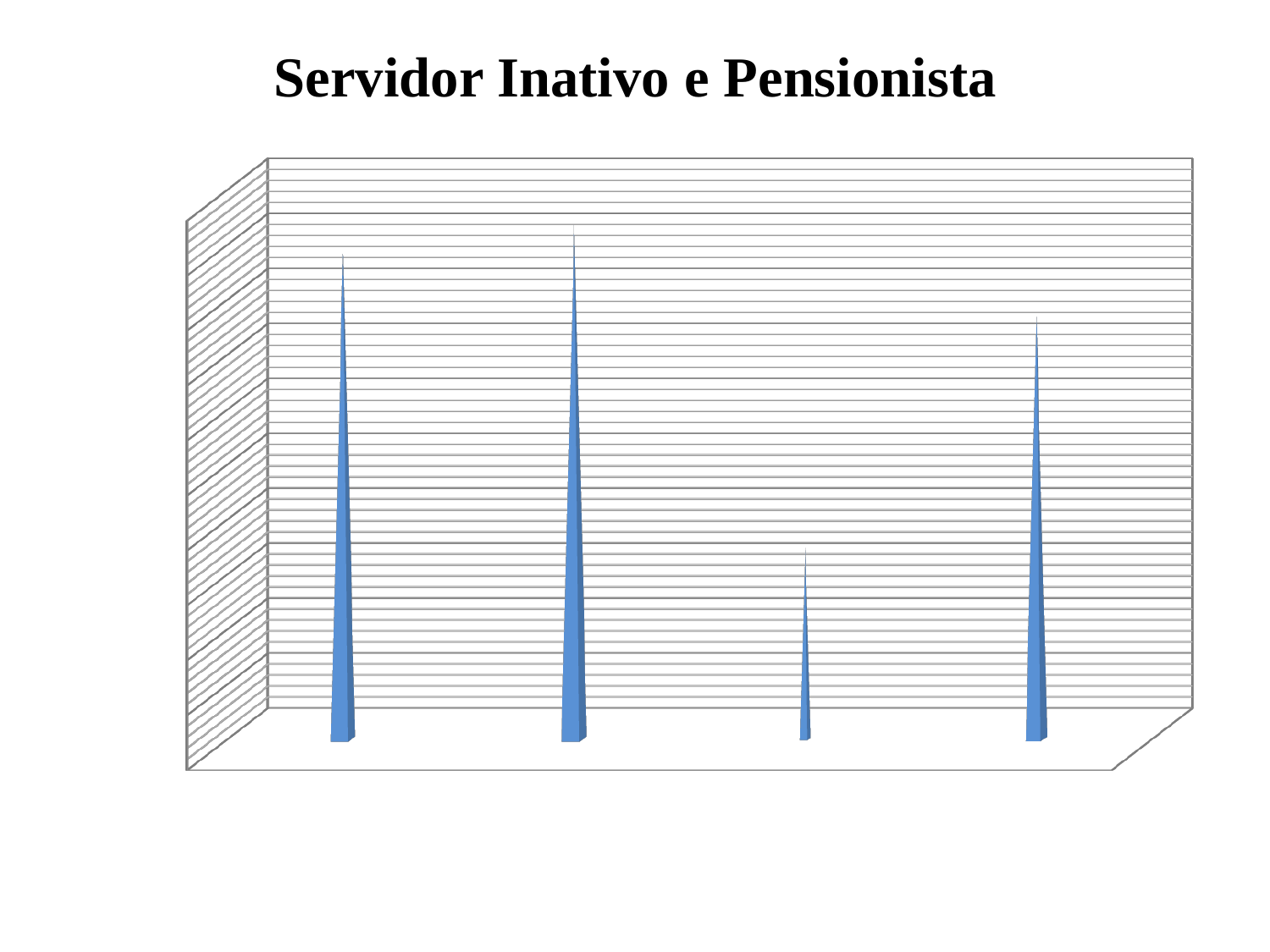
How many bars are plotted in the chart? 4 Which is taller, the second bar from the left or the third bar? the second bar Which bar is the tallest in the chart, counting from the left? the second bar What kind of chart is shown on the slide? bar chart What colour are the bars in the chart? blue Which bar is the shortest in the chart, counting from the left? the third bar What is the title of the chart? Servidor Inativo e Pensionista Which is taller, the third bar from the left or the fourth bar? the fourth bar Which is taller, the first bar from the left or the fourth bar? the first bar Do the bar heights rise steadily, fall steadily, or go up and down from left to right? go up and down